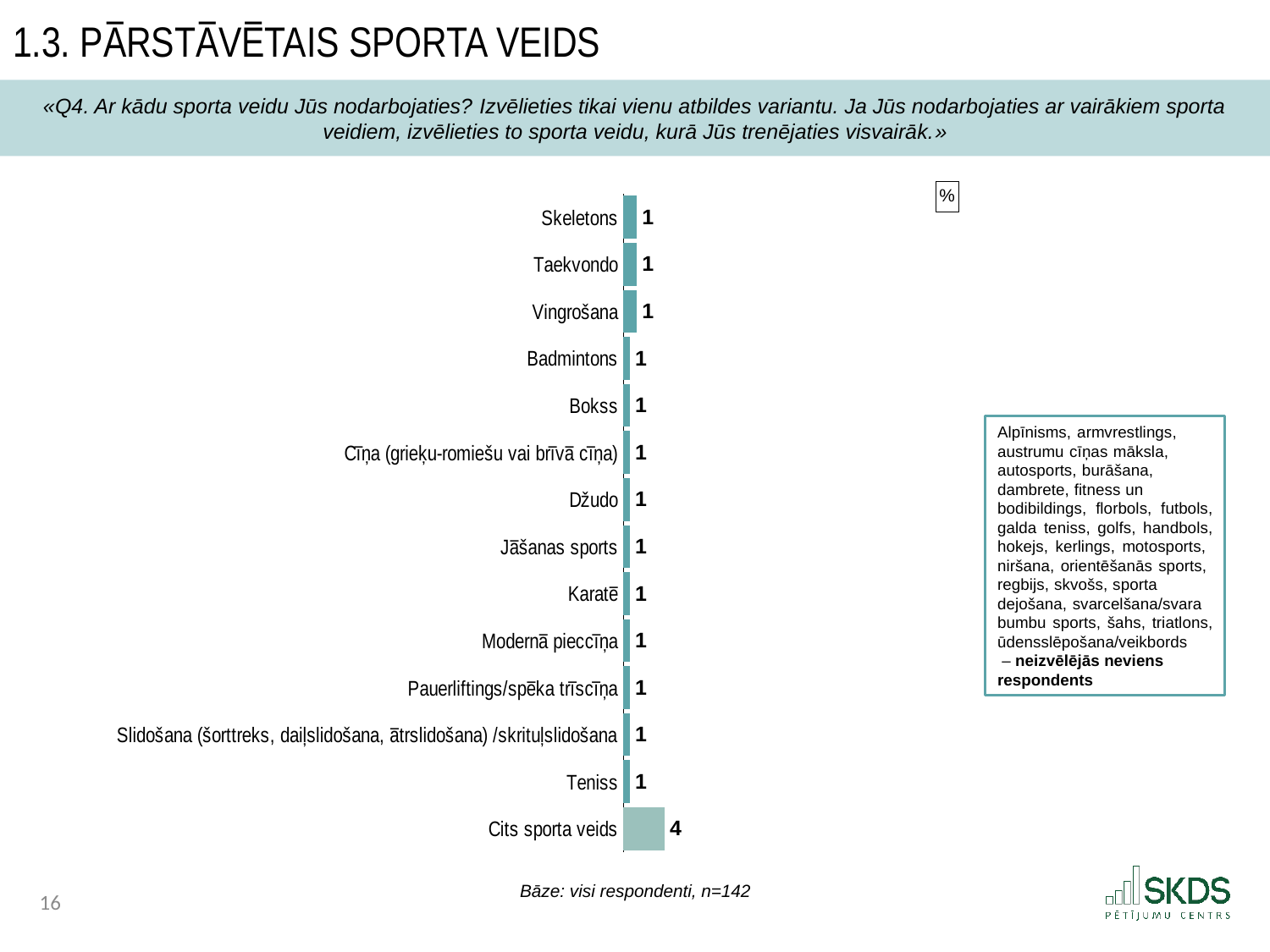
What is the base (n) stated below the chart? n=142 What unit is indicated for the chart values? % What is the value for Pauerliftings/spēka trīscīņa? 1 What is the value for Teniss? 1 Which category has the highest value? Cits sporta veids Which is larger, the value for Cits sporta veids or the value for Bokss? Cits sporta veids What is the value for Karatē? 1 What is the value for Cits sporta veids? 4 What is the value for Skeletons? 1 What is the difference between the values for Cits sporta veids and Džudo? 3 What kind of chart is shown on the slide? bar chart How many categories are plotted in the chart? 14